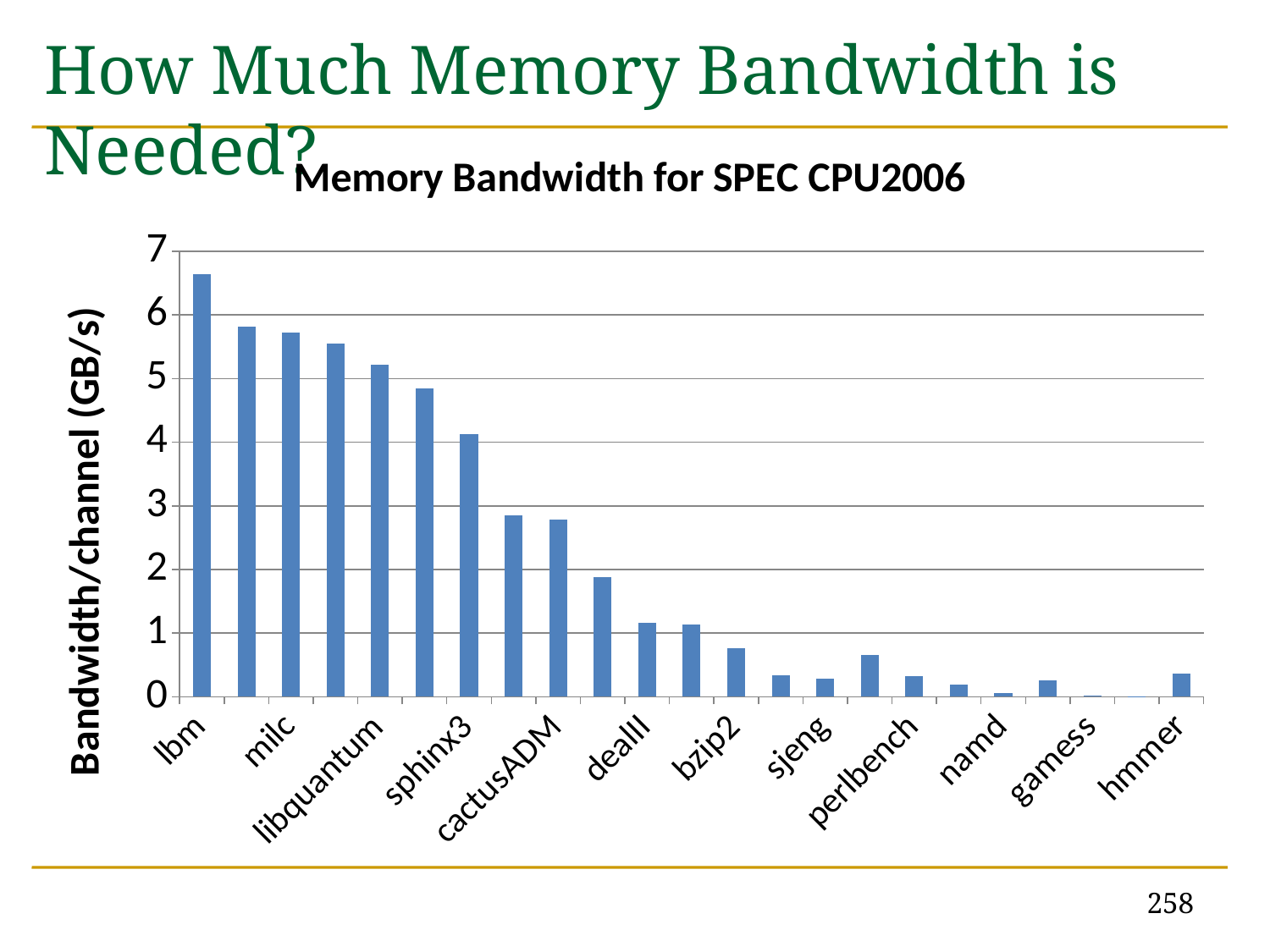
What type of chart is shown on the slide? bar chart Which has the larger bandwidth per channel, milc or dealII? milc Which has the larger bandwidth per channel, lbm or hmmer? lbm Is the value for dealII greater or less than 2? less Is the value for lbm greater or less than 6? greater Do the bandwidth values generally rise or fall moving from left to right along the x axis? fall Is the value for hmmer greater or less than 1? less What is the title of the chart? Memory Bandwidth for SPEC CPU2006 What is the label of the vertical axis? Bandwidth/channel (GB/s) Which benchmark has the highest memory bandwidth per channel? lbm